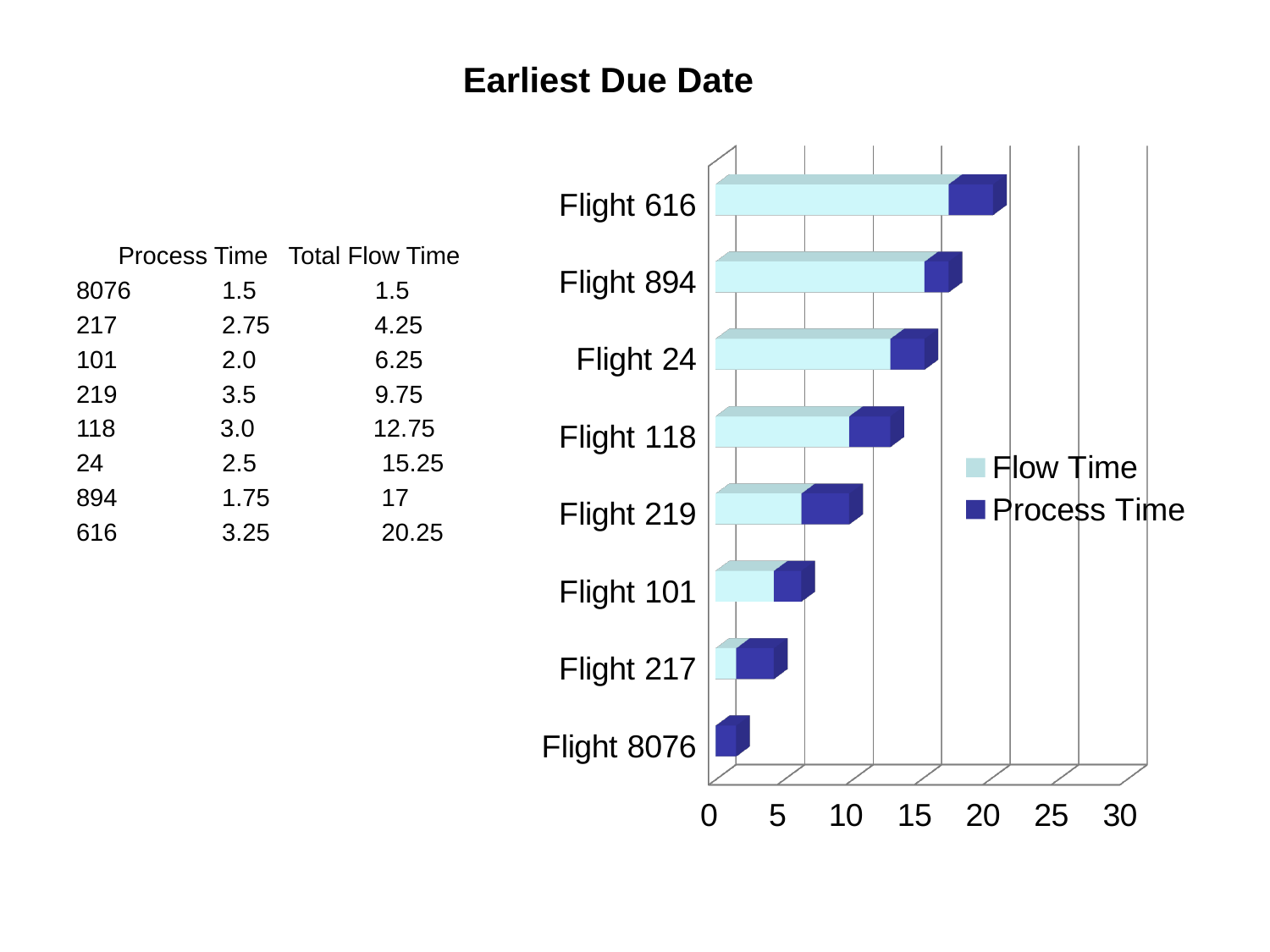
What are the two series named in the chart legend? Flow Time and Process Time Is the total bar length for Flight 217 greater or less than 5? less Which flight has the shortest total bar on the chart? Flight 8076 What kind of chart is shown on the slide? bar chart What is the title of the slide? Earliest Due Date How many flights are plotted on the chart? 8 Which has a longer total bar, Flight 24 or Flight 118? Flight 24 According to the table on the slide, what is the process time for flight 219? 3.5 How many series does the chart legend list? 2 According to the table on the slide, what is the total flow time for flight 616? 20.25 Which flight has the longest total bar on the chart? Flight 616 Is the total bar length for Flight 894 greater or less than 15? greater